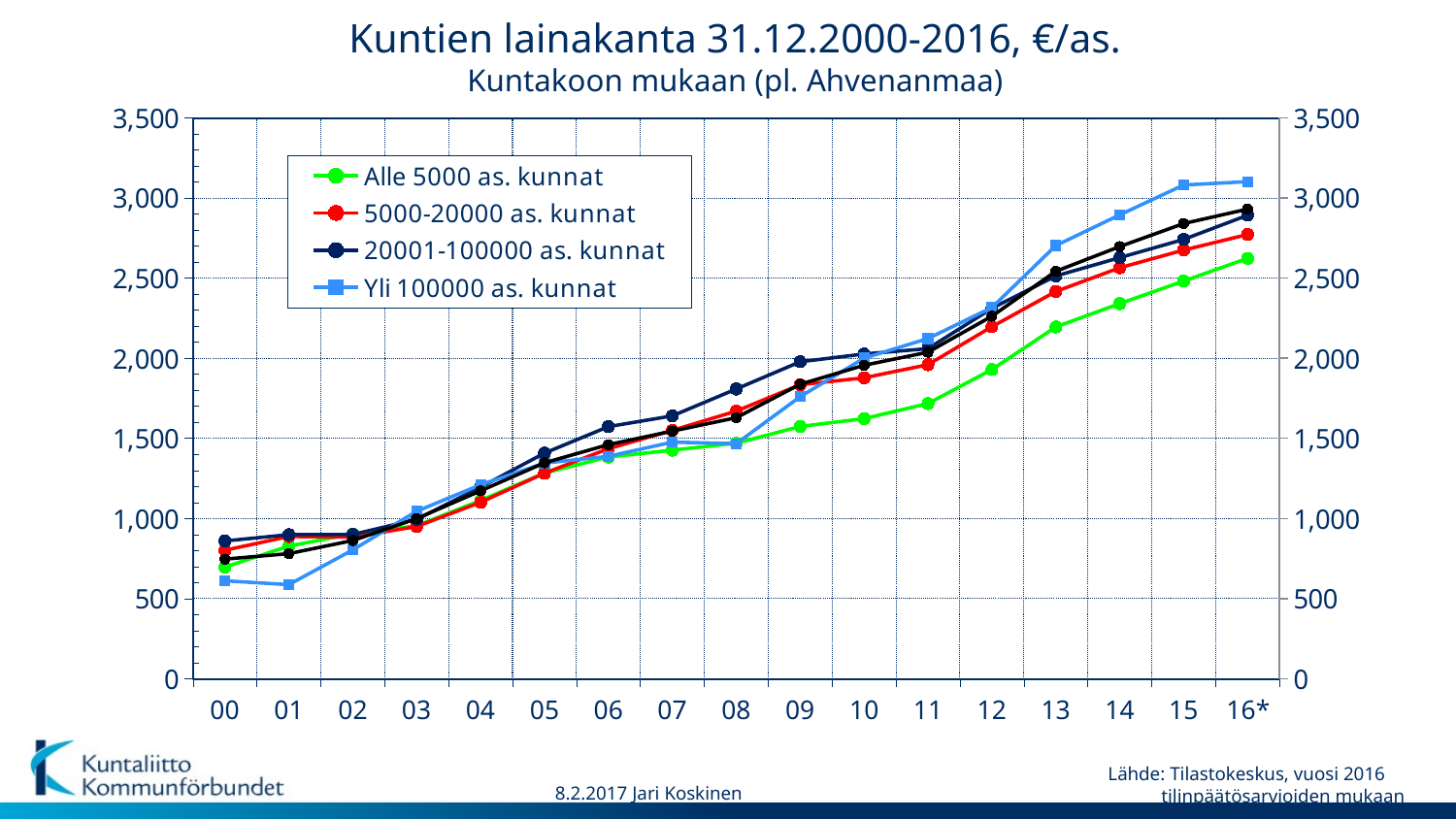
In 08, which is larger: the value for 20001-100000 as. kunnat or the value for Yli 100000 as. kunnat? 20001-100000 as. kunnat Is the value for Alle 5000 as. kunnat in 16* greater or less than 2,500? greater What is the title of the chart? Kuntien lainakanta 31.12.2000-2016, €/as. Which series has the lowest value in 16*? Alle 5000 as. kunnat How many series does the legend list? 4 Which series has the highest value in 16*? Yli 100000 as. kunnat Is the value for Yli 100000 as. kunnat in 16* greater or less than 3,000? greater Is the value for Alle 5000 as. kunnat in 00 greater or less than 1,000? less What kind of chart is shown on the slide? line chart Which series has the lowest value in 00? Yli 100000 as. kunnat Do the values for the series generally rise or fall from 00 to 16*? rise How many years are shown along the x axis? 17